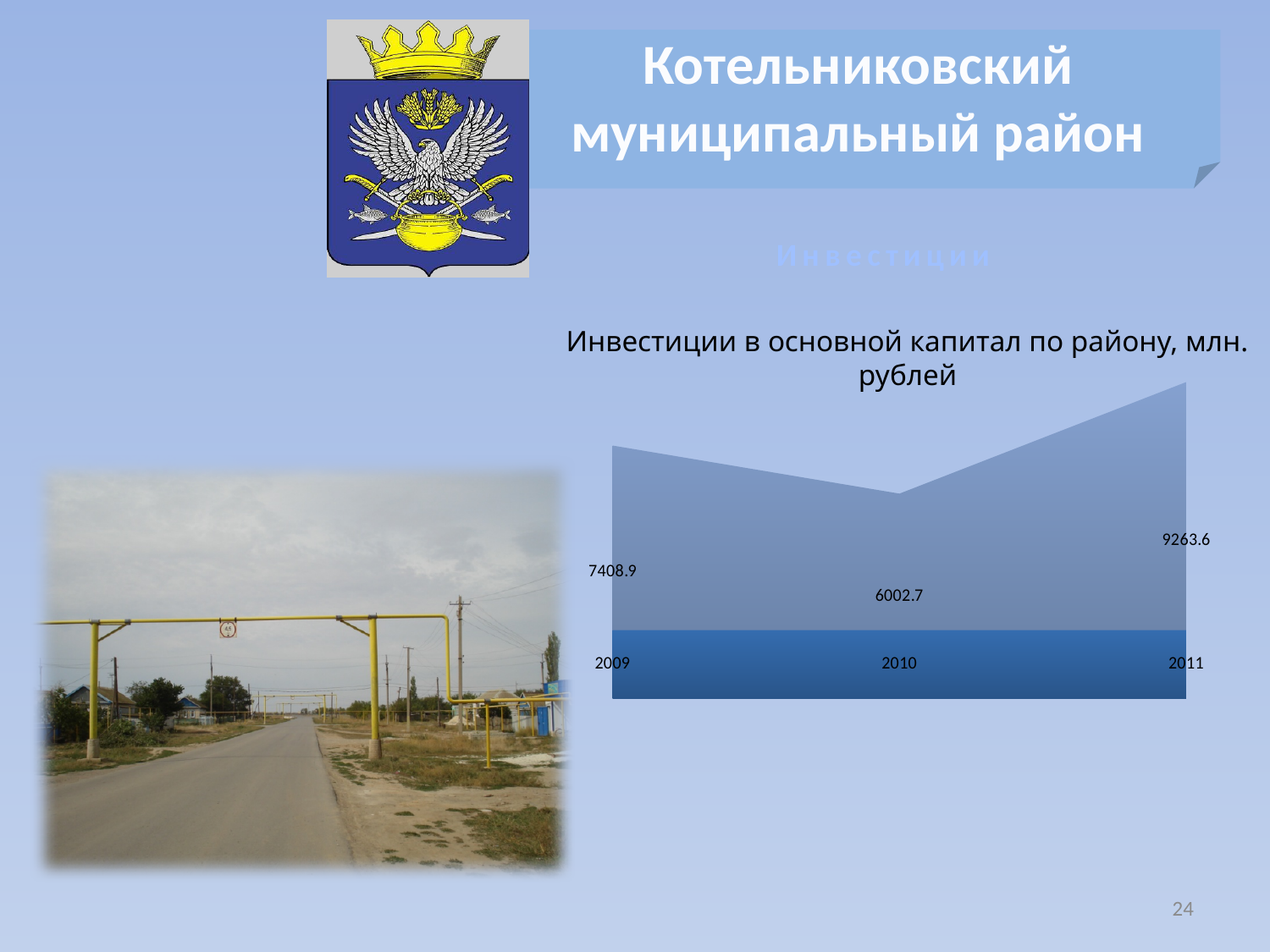
What is the value for 2010 in the chart? 6002.7 What is the title of the chart? Инвестиции в основной капитал по району, млн. рублей What is the value for 2009 in the chart? 7408.9 What is the difference between the values for 2009 and 2010? 1406.2 What is the value for 2011 in the chart? 9263.6 What kind of chart is shown on the slide? Area chart Which year has the highest value in the chart? 2011 Which year has the lowest value in the chart? 2010 Does the value fall or rise from 2010 to 2011? Rise How many years are plotted in the chart? 3 Which is larger, the value for 2009 or the value for 2011? 2011 What is the difference between the values for 2011 and 2010? 3260.9